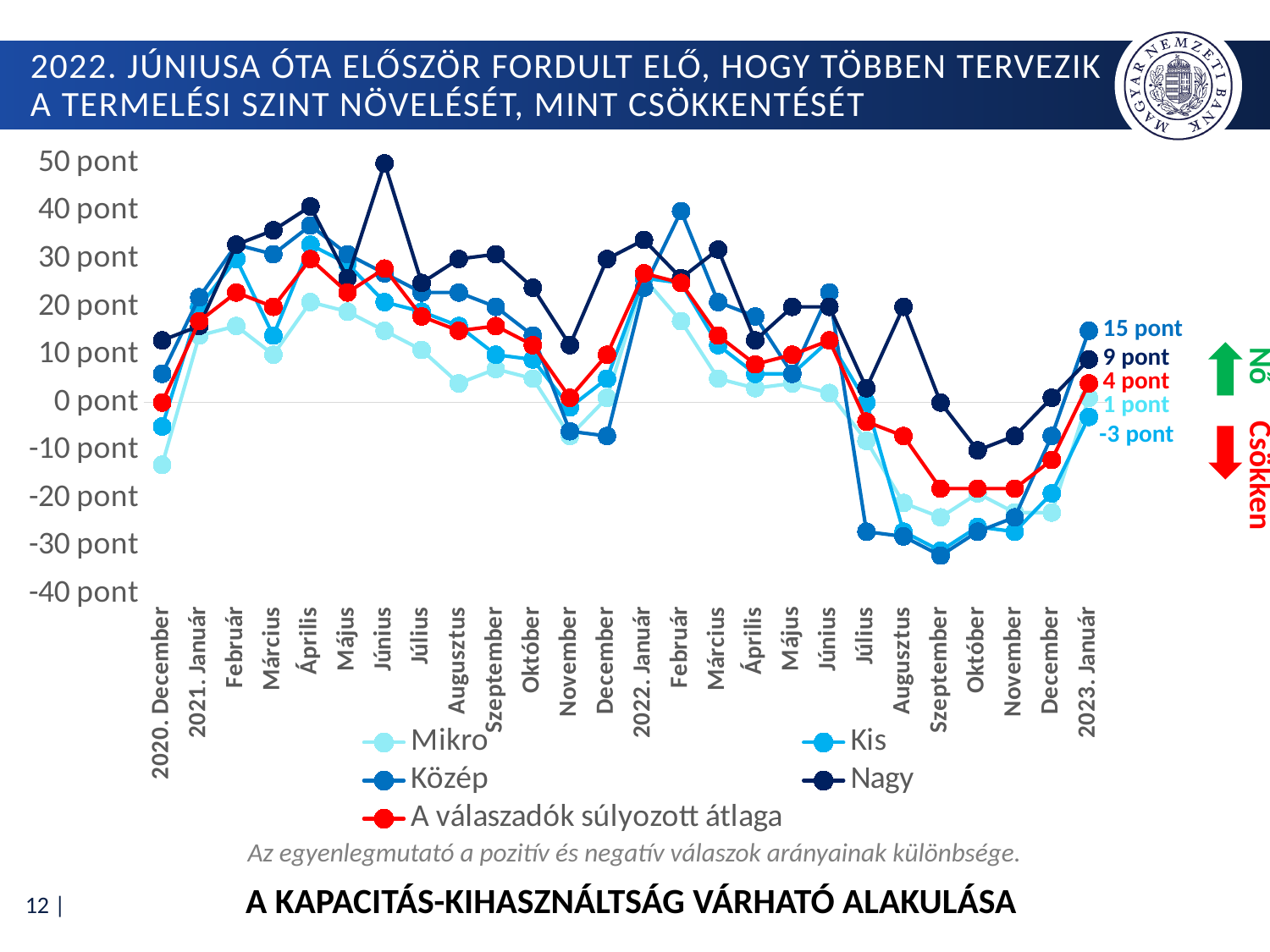
What is the value of the Kis series at 2023. Január? -3 pont Is the value for the Nagy series at 2021. Június greater or less than 40 pont? greater What is the value of the Nagy series at 2023. Január? 9 pont What kind of chart is shown on the slide? line chart Which series has the highest value at 2023. Január? Közép Is the value for the Közép series at 2022. Július greater or less than -20 pont? less What is the value of the Mikro series at 2023. Január? 1 pont What is the difference between the Közép and Nagy values at 2023. Január? 6 pont What is the value of 'A válaszadók súlyozott átlaga' at 2023. Január? 4 pont How many series does the legend list? 5 How many months (categories) are shown on the x axis? 26 What is the value of the Közép series at 2023. Január? 15 pont